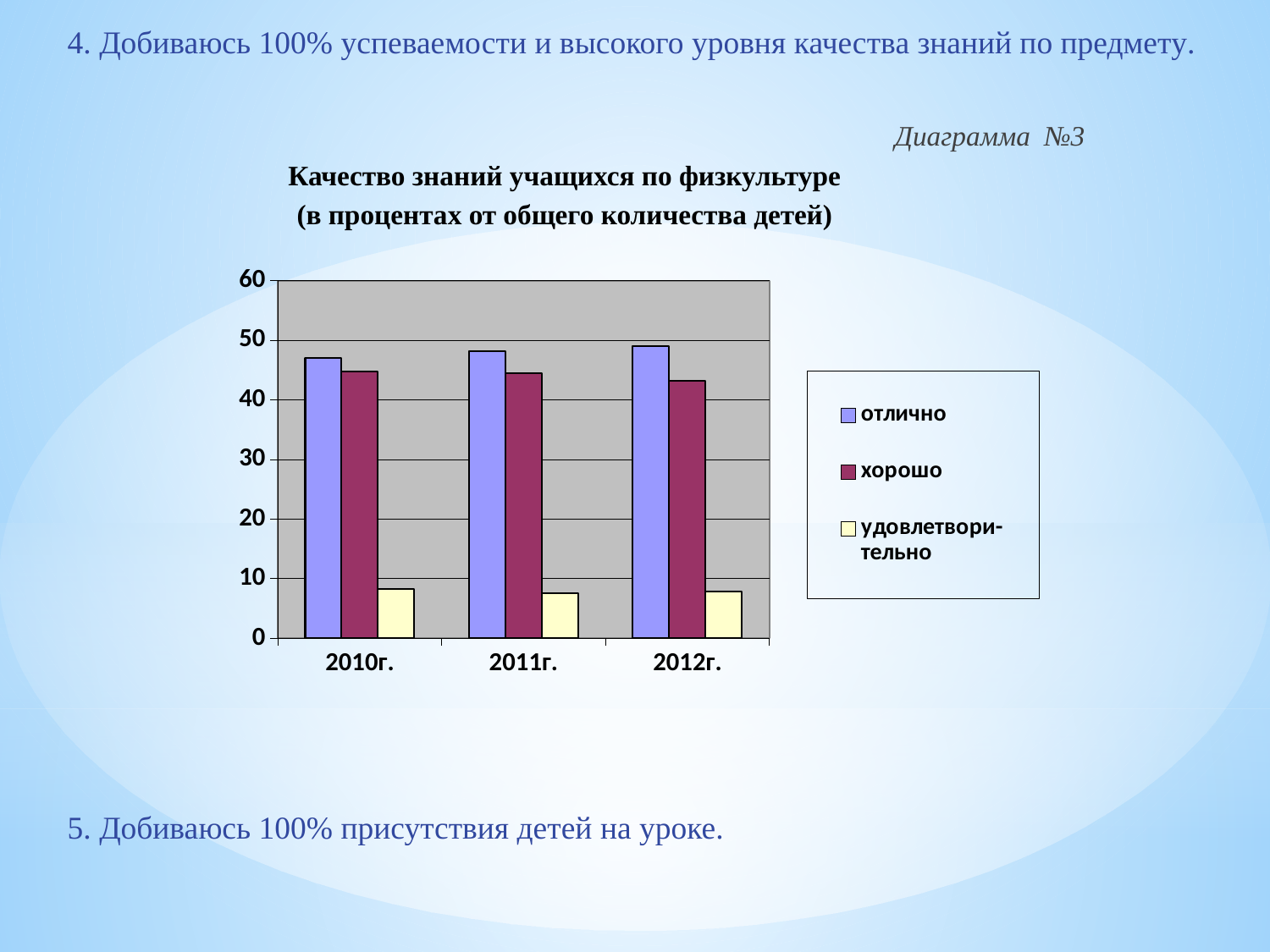
How many years are shown on the x axis? 3 Does the value for хорошо rise or fall from 2010г. to 2012г.? fall What kind of chart is shown on the slide? bar chart How many series does the legend list? 3 In which year is the value for хорошо the lowest? 2012г. Is the value for удовлетворительно in 2011г. greater or less than 10? less In 2012г., which is larger: отлично or хорошо? отлично Is the value for хорошо in 2012г. greater or less than 40? greater What is the title of the chart? Качество знаний учащихся по физкультуре (в процентах от общего количества детей) Which series is shown in light yellow? удовлетворительно Is the value for отлично in 2010г. greater or less than 40? greater